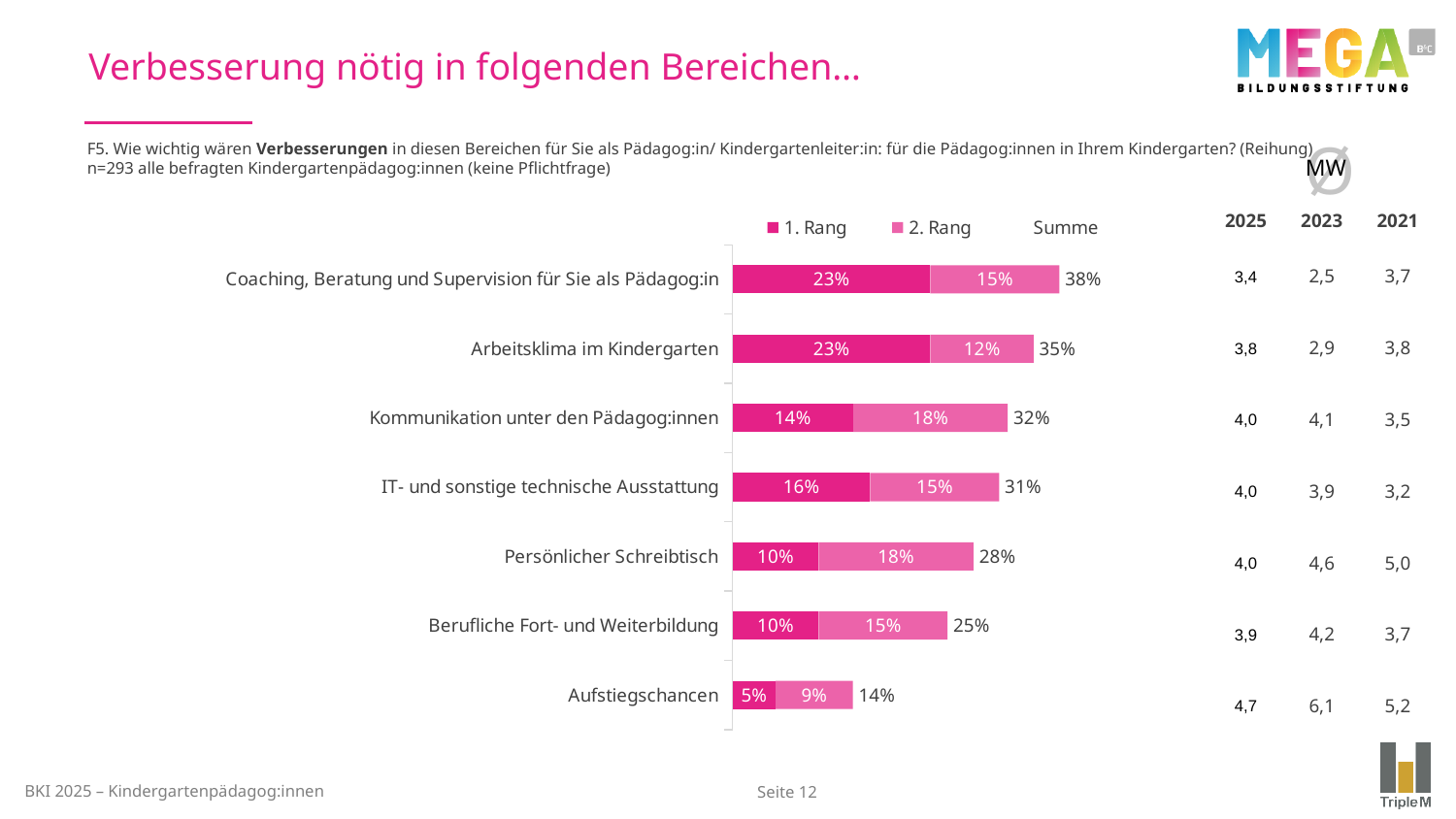
What is the difference between the Summe values for "Arbeitsklima im Kindergarten" and "Aufstiegschancen"? 21% How many categories are shown in the bar chart? 7 What is the MW value for 2023 for "Aufstiegschancen"? 6,1 How many series does the legend list with coloured markers? 2 What is the Summe value for "Persönlicher Schreibtisch"? 28% What kind of chart is shown on the slide? Stacked bar chart Which is larger: the 1. Rang value for "IT- und sonstige technische Ausstattung" or the 1. Rang value for "Berufliche Fort- und Weiterbildung"? IT- und sonstige technische Ausstattung What is the 2. Rang value for "Kommunikation unter den Pädagog:innen"? 18% Which category has the highest Summe value? Coaching, Beratung und Supervision für Sie als Pädagog:in What is the 1. Rang value for "Coaching, Beratung und Supervision für Sie als Pädagog:in"? 23% What is the total of the stacked bar for "Aufstiegschancen" (1. Rang plus 2. Rang)? 14% Which category has the lowest Summe value? Aufstiegschancen